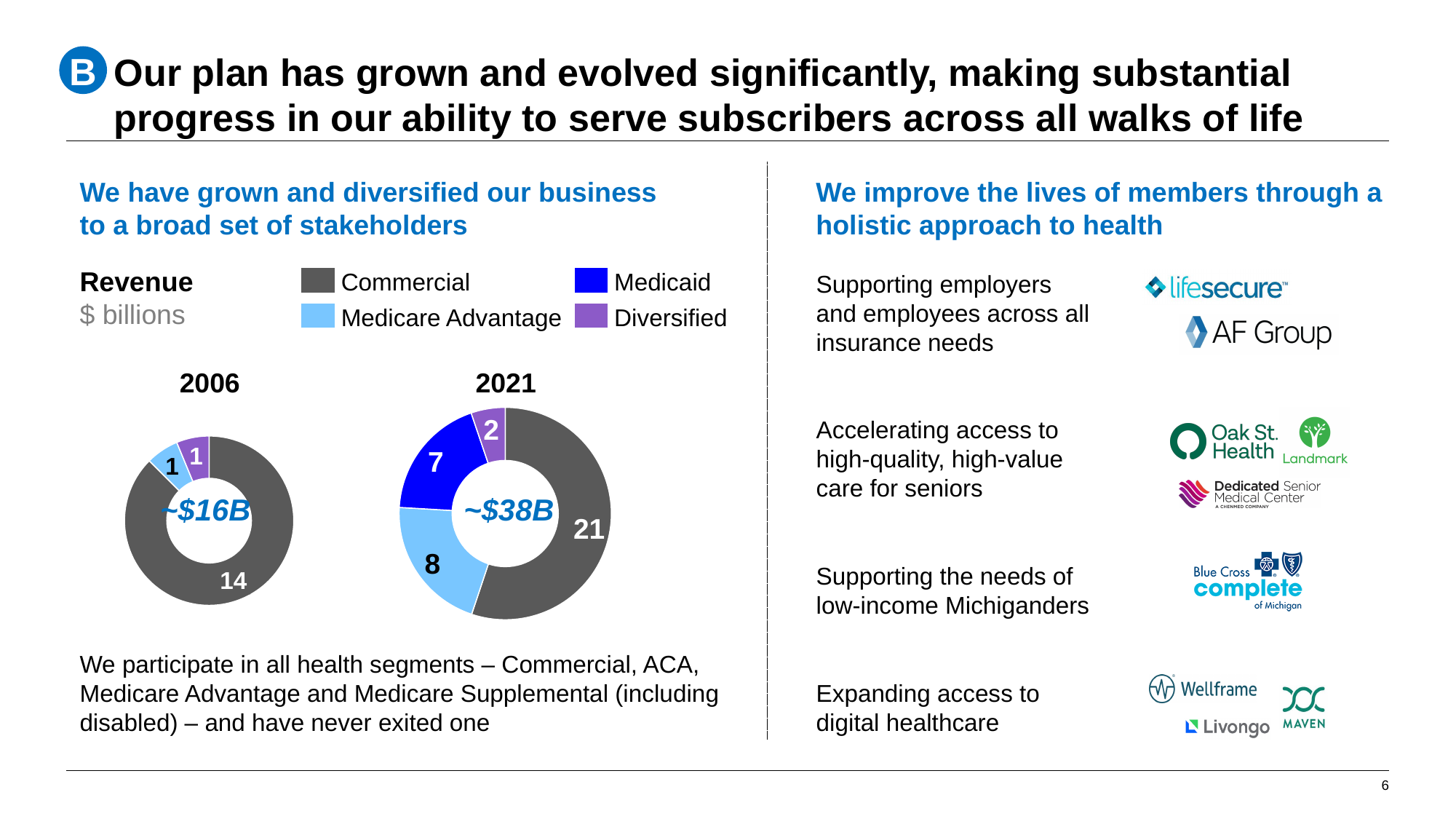
How many segments are shown in the 2006 donut chart? 3 In the 2021 donut chart, which segment has the smallest revenue? Diversified How many series does the legend list for the revenue charts? 4 In the 2021 donut chart, what is the revenue value for Medicare Advantage? 8 In the 2021 donut chart, which segment has the largest revenue? Commercial What kind of chart is used to show revenue for 2006 and 2021? Donut chart In the 2021 donut chart, what is the revenue value for Medicaid? 7 What total revenue is shown in the centre of the 2021 donut chart? ~$38B How much larger is Commercial revenue in the 2021 chart than in the 2006 chart? 7 In the 2021 donut chart, which is larger: Medicare Advantage or Medicaid? Medicare Advantage In the 2021 donut chart, what is the revenue value for Commercial? 21 In the 2006 donut chart, what is the revenue value for Commercial? 14